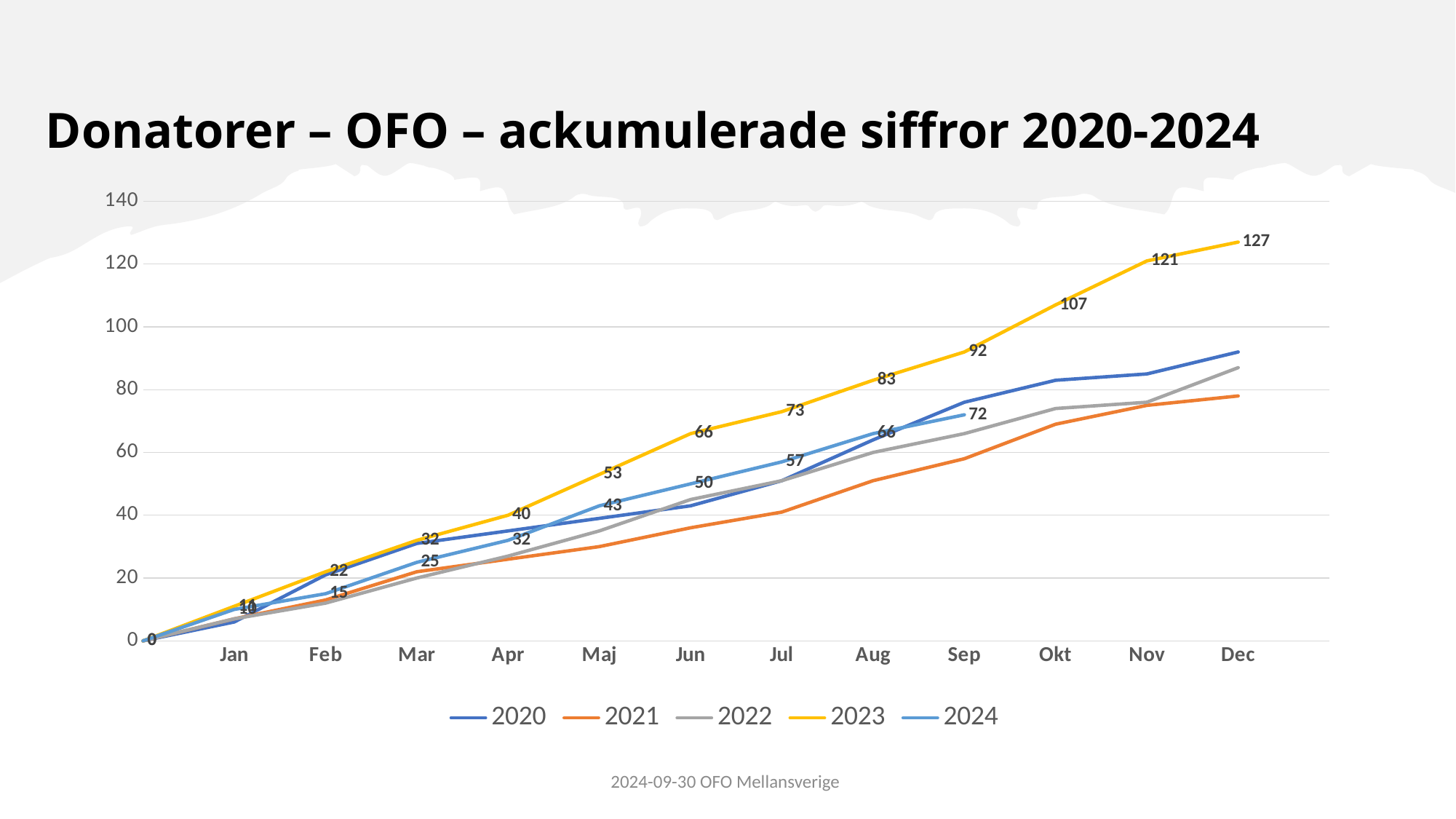
What is the value for 2023 in Jun? 66 What is the difference between the 2023 values for Dec and Nov? 6 What is the difference between the 2023 values for Okt and Sep? 15 How many series does the legend list? 5 What is the value for 2024 in Sep? 72 What is the value for 2023 in Nov? 121 What kind of chart is shown on the slide? line chart What is the value for 2023 in Dec? 127 Is the value for 2020 in Dec greater or less than 80? greater Which series has the highest value in Dec? 2023 Which is larger in Jul, the value for 2023 or the value for 2024? 2023 Do the values for 2023 rise or fall from Jan to Dec? rise